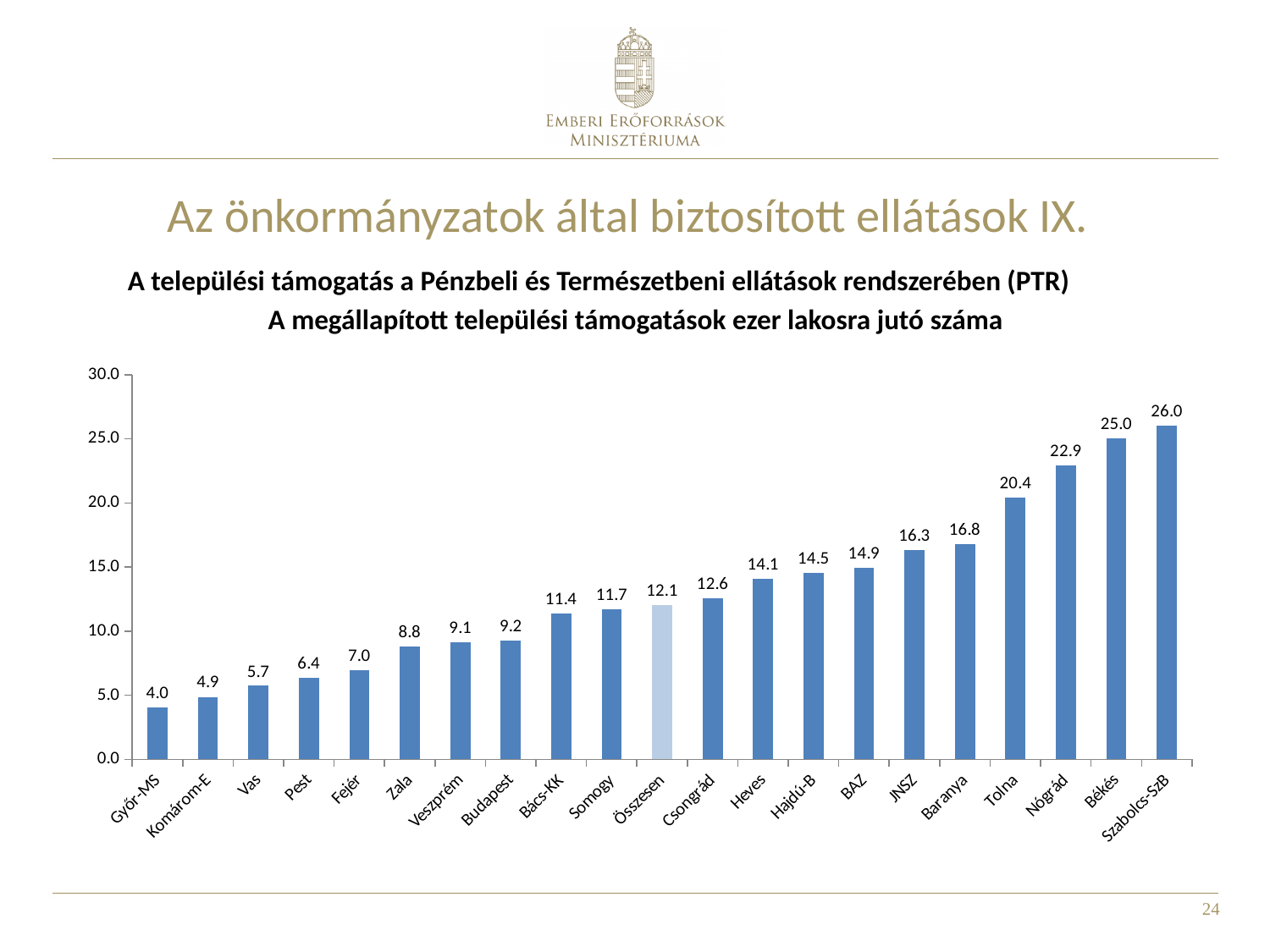
Which category has the lowest value? Győr-MS Which category has the highest value? Szabolcs-SzB Which is larger, the value for Heves or the value for Zala? Heves Is the value for Baranya greater or less than 15.0? greater What is the value for Budapest? 9.2 Do the values rise or fall from left to right along the x axis? rise What is the value for Tolna? 20.4 What is the value for Összesen? 12.1 What is the difference between the values for Szabolcs-SzB and Győr-MS? 22.0 What is the difference between the values for Nógrád and Tolna? 2.5 What kind of chart is shown on the slide? bar chart How many categories are shown on the x axis? 21